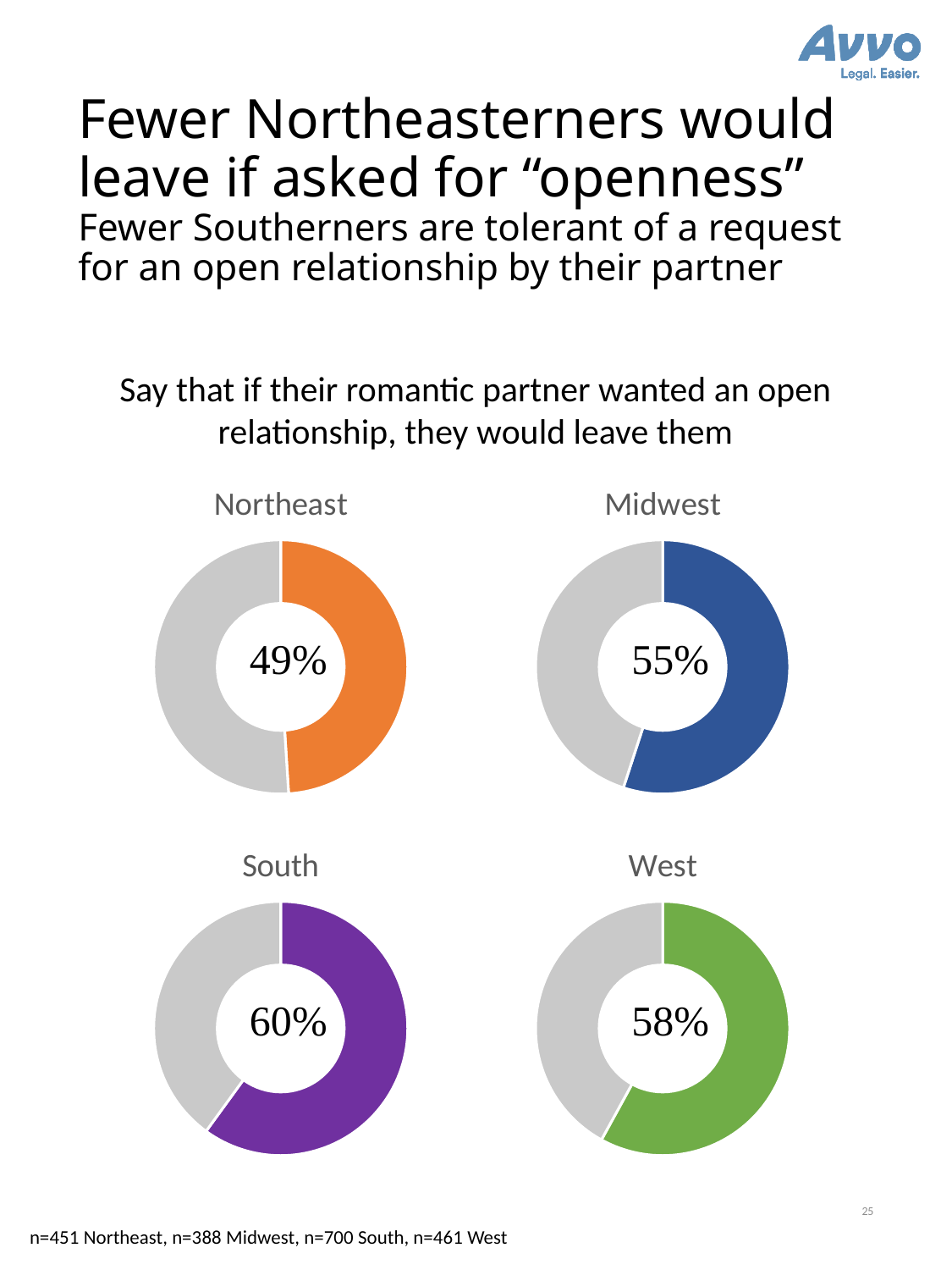
In the South chart, what percentage say they would leave if their partner wanted an open relationship? 60% Across the four regional charts, which region has the highest percentage who would leave? South How many regional donut charts are shown on the slide? 4 Which is larger, the percentage in the Midwest chart or the percentage in the West chart? West Across the four regional charts, which region has the lowest percentage who would leave? Northeast In the West chart, what percentage say they would leave if their partner wanted an open relationship? 58% What colour is the highlighted segment in the Northeast chart? Orange What kind of chart is used for each region on the slide? Donut (pie) chart In the Northeast chart, what percentage say they would leave if their partner wanted an open relationship? 49% In the Midwest chart, what percentage say they would leave if their partner wanted an open relationship? 55% What is the difference in percentage points between the South chart and the Northeast chart? 11 What colour is the highlighted segment in the South chart? Purple